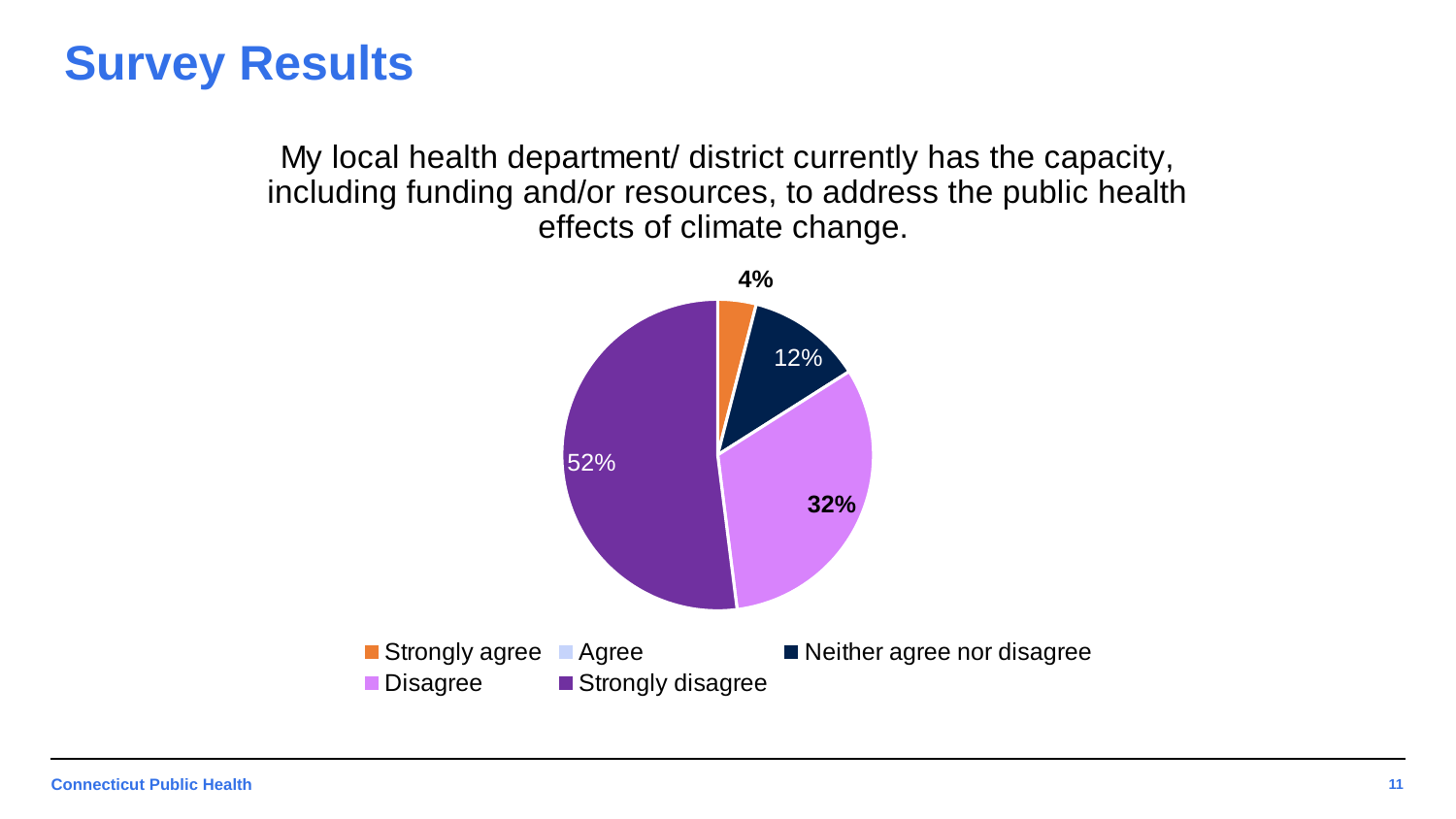
What is the difference in percentage points between "Strongly disagree" and "Disagree"? 20 What percentage of respondents selected "Strongly agree"? 4% What percentage of respondents selected "Disagree"? 32% What kind of chart is shown on the slide? Pie chart Which labelled slice of the pie is the smallest? Strongly agree What percentage of respondents selected "Strongly disagree"? 52% What colour is the "Strongly agree" slice in the pie chart? Orange How many response categories does the legend list? 5 What percentage of respondents selected "Neither agree nor disagree"? 12% What is the combined percentage of respondents who selected "Disagree" or "Strongly disagree"? 84% Which response category has the largest share of the pie? Strongly disagree Which is larger, the share for "Neither agree nor disagree" or the share for "Strongly agree"? Neither agree nor disagree